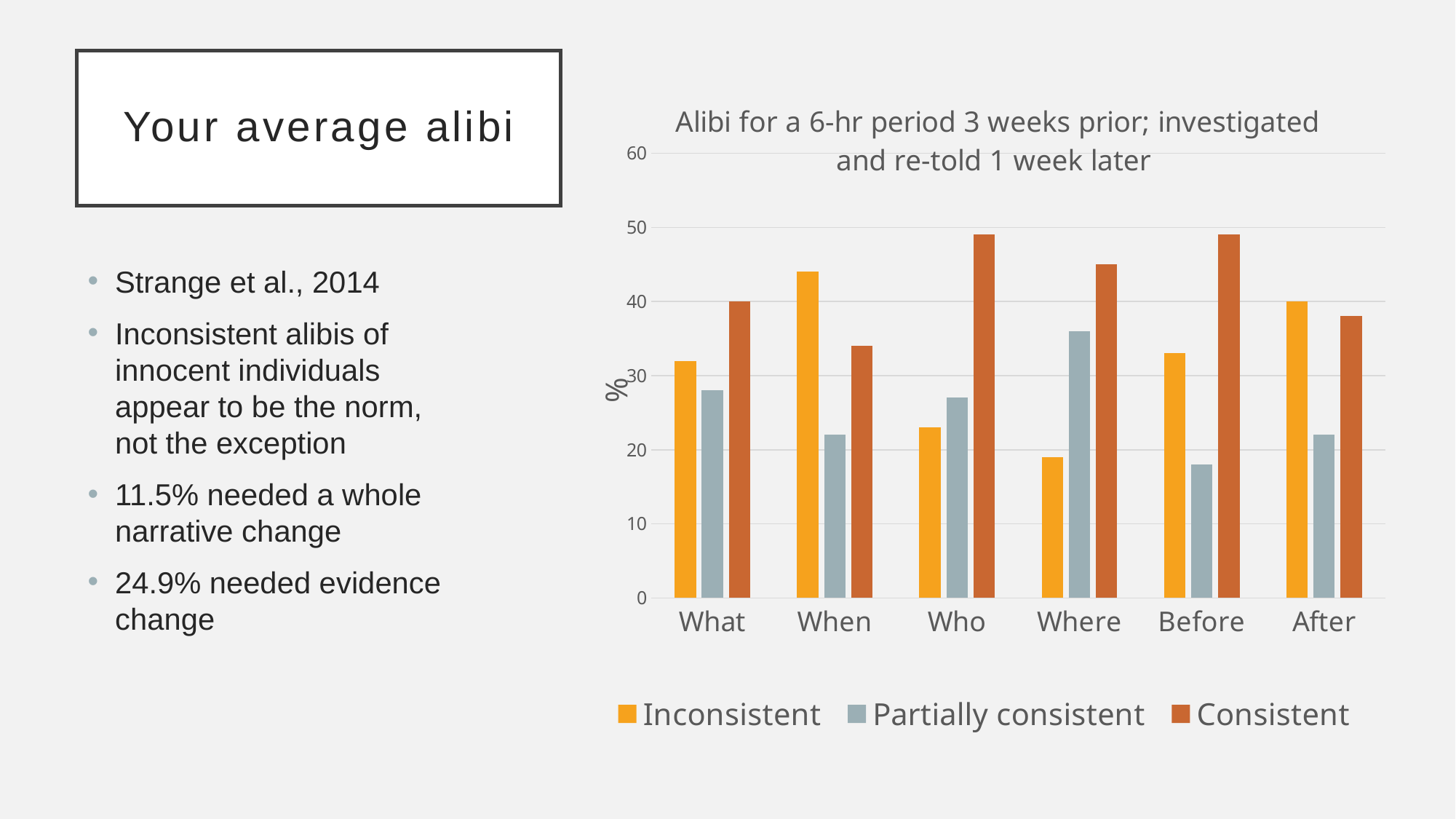
What kind of chart is shown on the slide? Bar chart What is the title of the chart? Alibi for a 6-hr period 3 weeks prior; investigated and re-told 1 week later Is the Consistent value for Who greater or less than 40? greater Which series is shown in the darkest orange-brown colour in the chart? Consistent Is the Inconsistent value for When greater or less than 40? greater Which category has the lowest Partially consistent value? Before Is the Partially consistent value for Before greater or less than 20? less How many series does the chart legend list? 3 Which category has the highest Inconsistent value? When How many categories are shown along the x axis of the chart? 6 For the Where category, which series has the larger value: Inconsistent or Partially consistent? Partially consistent